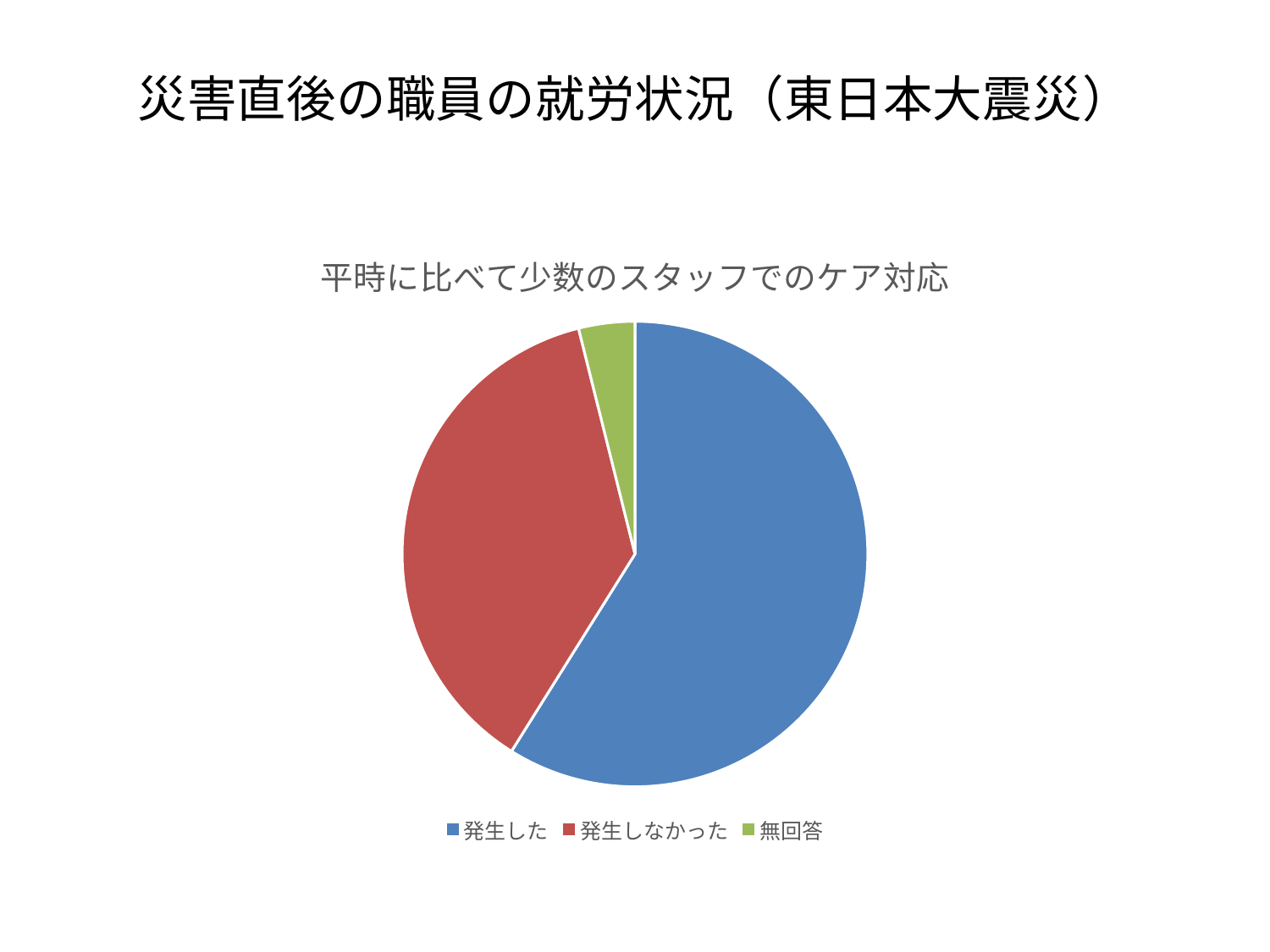
What kind of chart is shown on the slide? Pie chart Which slice is larger, 発生しなかった or 無回答? 発生しなかった How many entries does the legend of the pie chart list? 3 What colour is the 無回答 slice in the pie chart? Green Which slice is larger, 発生した or 発生しなかった? 発生した How many slices does the pie chart have? 3 What is the title of the pie chart? 平時に比べて少数のスタッフでのケア対応 Does the 発生した slice take up more or less than half of the pie? more Which category has the smallest slice in the pie chart? 無回答 Which category has the largest slice in the pie chart? 発生した